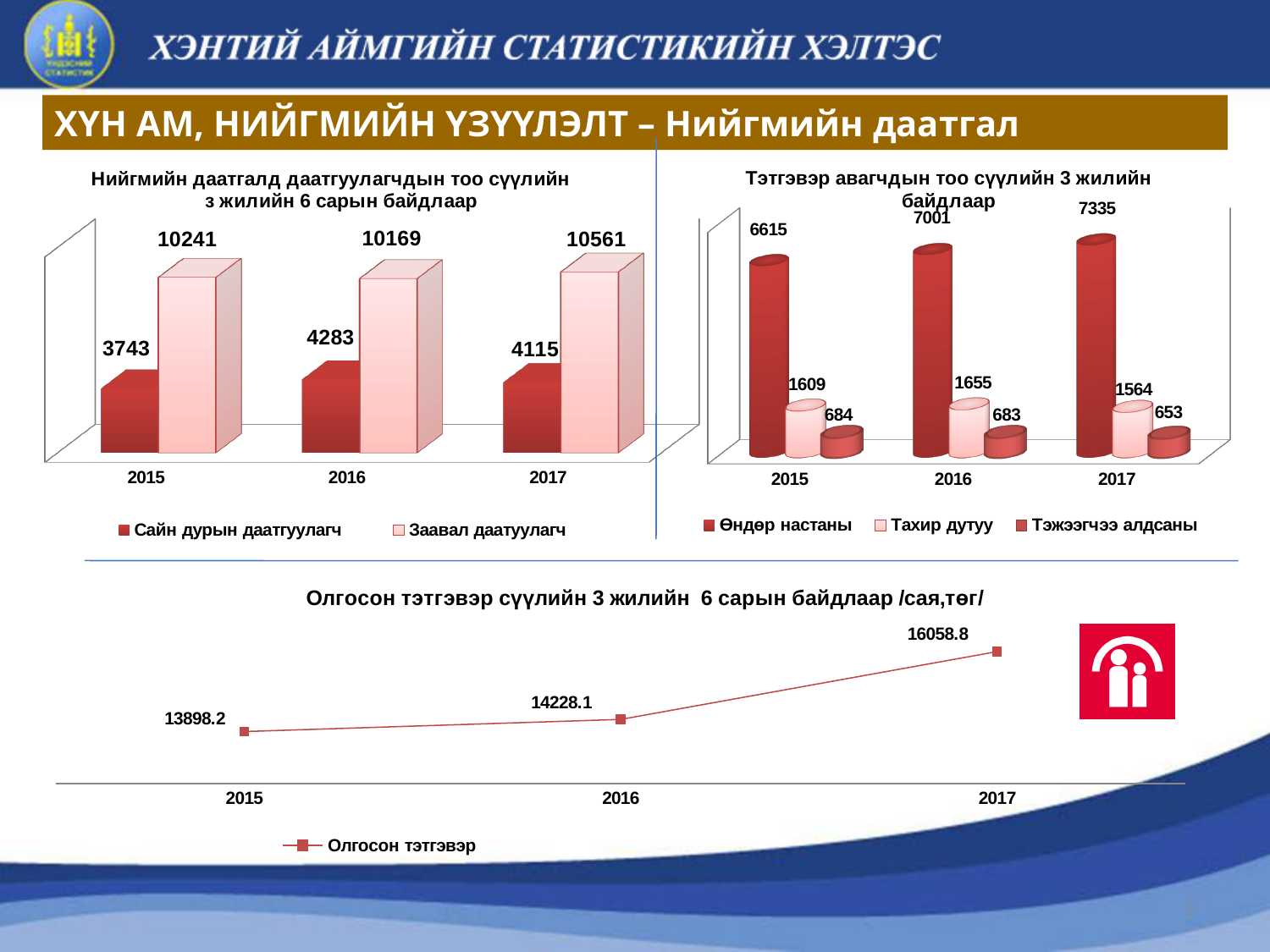
In the bottom chart (Олгосон тэтгэвэр), what is the value for 2016? 14228.1 In the top-right chart (Тэтгэвэр авагчдын тоо), does Өндөр настаны rise or fall from 2015 to 2017? rise In the top-right chart (Тэтгэвэр авагчдын тоо), in which year is Тахир дутуу highest? 2016 In the top-left chart (Нийгмийн даатгалд даатгуулагчдын тоо), what is the value for Сайн дурын даатгуулагч in 2016? 4283 In the top-right chart (Тэтгэвэр авагчдын тоо), what is the value for Тэжээгчээ алдсаны in 2016? 683 In the top-left chart (Нийгмийн даатгалд даатгуулагчдын тоо), what is the value for Заавал даатуулагч in 2017? 10561 In the top-left chart (Нийгмийн даатгалд даатгуулагчдын тоо), what is the difference between Заавал даатуулагч and Сайн дурын даатгуулагч in 2015? 6498 In the top-right chart (Тэтгэвэр авагчдын тоо), how many series does the legend list? 3 In the top-left chart (Нийгмийн даатгалд даатгуулагчдын тоо), how many series does the legend list? 2 What kind of chart is the bottom chart (Олгосон тэтгэвэр)? line chart In the top-right chart (Тэтгэвэр авагчдын тоо), what is the value for Өндөр настаны in 2017? 7335 In the bottom chart (Олгосон тэтгэвэр), what is the difference between the 2017 and 2015 values? 2160.6